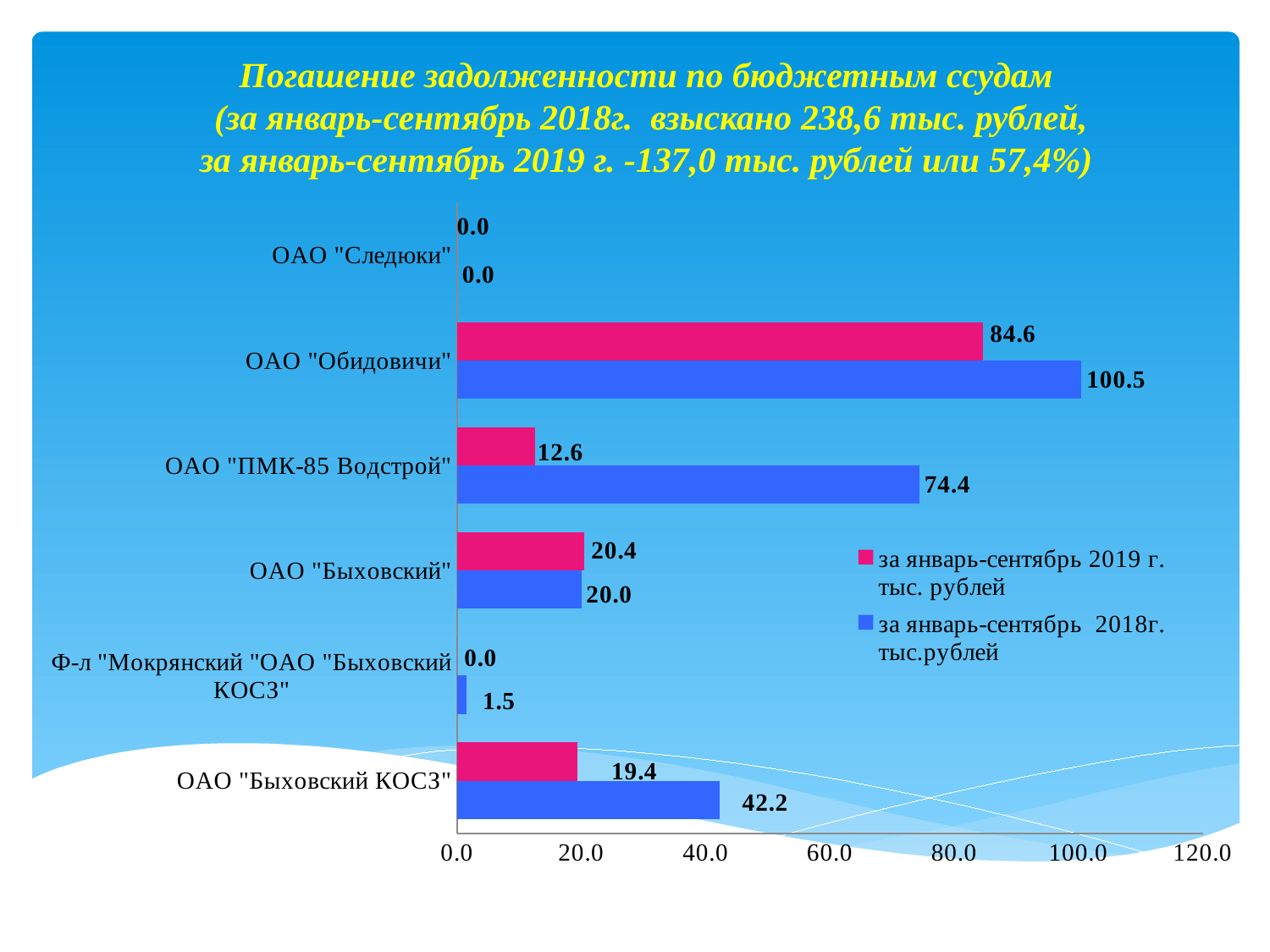
What is the value for ОАО "Быховский КОСЗ" for January–September 2018? 42.2 What is the value for ОАО "Обидовичи" for January–September 2019? 84.6 What is the value for Ф-л "Мокрянский" ОАО "Быховский КОСЗ" for January–September 2018? 1.5 Which organisation has the lowest value for January–September 2018? ОАО "Следюки" Which organisation has the highest value for January–September 2018? ОАО "Обидовичи" Which colour represents the series for January–September 2019? pink How many organisations (categories) are shown on the chart? 6 What is the value for ОАО "ПМК-85 Водстрой" for January–September 2018? 74.4 What is the difference between the 2018 and 2019 values for ОАО "ПМК-85 Водстрой"? 61.8 How many series does the legend list? 2 What type of chart is shown on the slide? bar chart Which is larger for ОАО "Быховский КОСЗ": the January–September 2018 value or the January–September 2019 value? January–September 2018 (42.2)